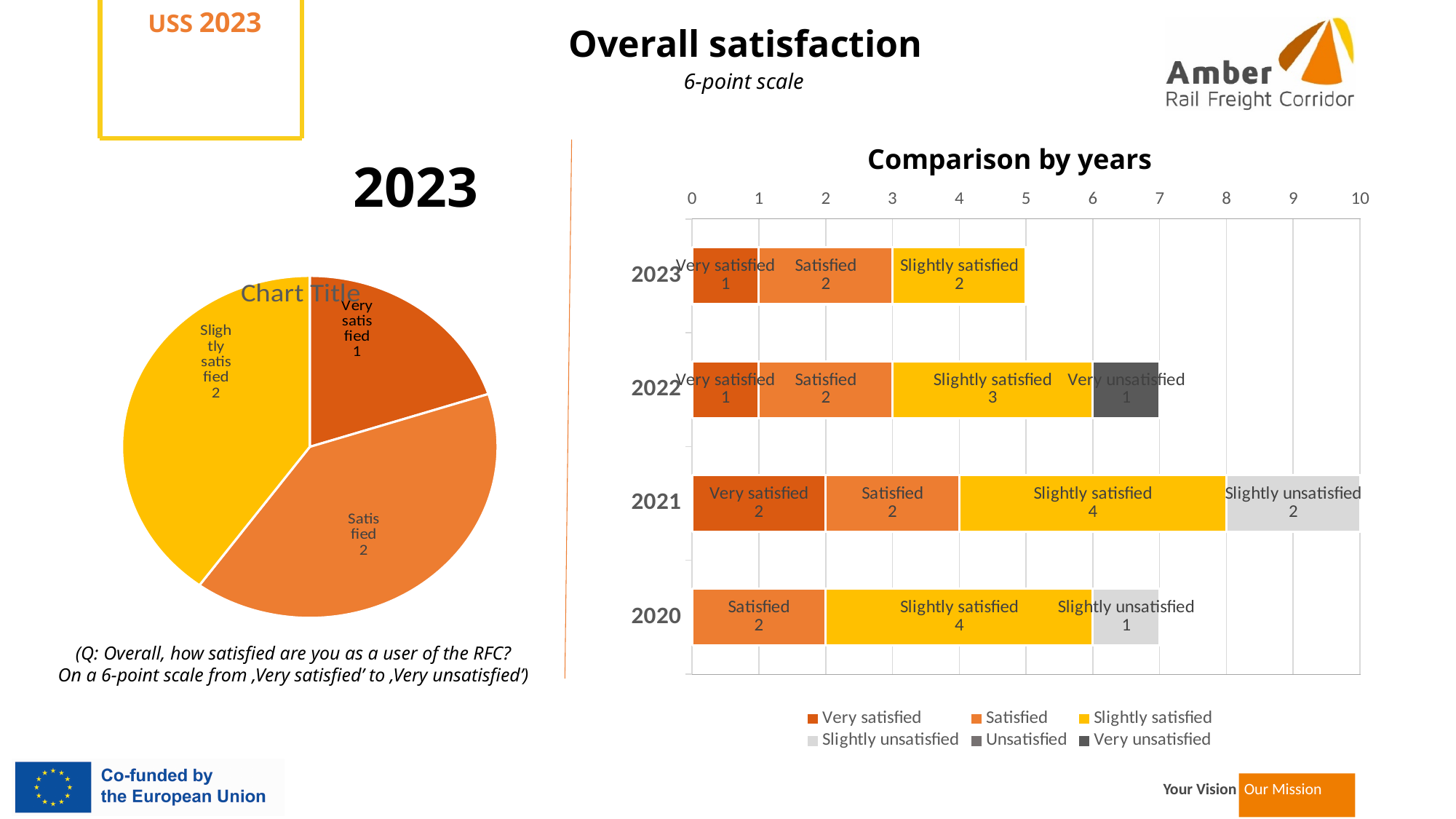
In the 2023 pie chart, what share of the total does the Very satisfied slice represent? 20% What kind of chart is the 'Comparison by years' chart? Stacked bar chart In the 'Comparison by years' chart, what is the difference between the Slightly satisfied values for 2021 and 2023? 2 In the 'Comparison by years' chart, how many years are shown? 4 In the 'Comparison by years' chart, what is the total of the stacked bar for 2022? 7 In the 'Comparison by years' chart, what is the value for Slightly satisfied in 2021? 4 In the 2023 pie chart, what is the value for Very satisfied? 1 In the 'Comparison by years' chart, how many series does the legend list? 6 In the 'Comparison by years' chart, which year has the highest total number of responses? 2021 In the 'Comparison by years' chart, what is the value for Slightly unsatisfied in 2020? 1 In the 'Comparison by years' chart, what is the total of the stacked bar for 2021? 10 In the 'Comparison by years' chart, what is the value for Very unsatisfied in 2022? 1